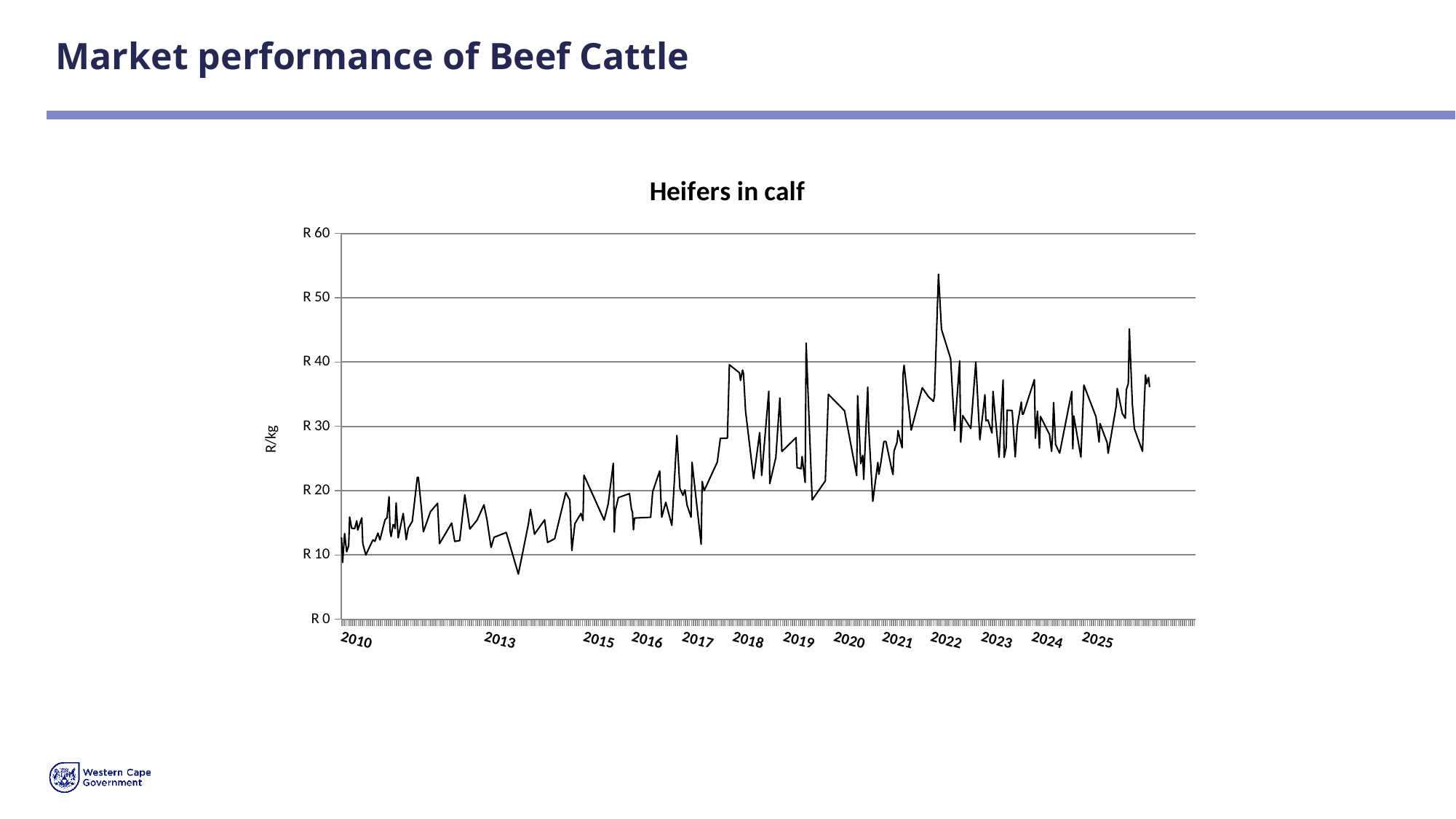
Are the values at the start of the series in 2010 greater or less than R 20? less Overall, do the values rise or fall from 2010 to 2025? Rise Is the spike in the line during 2025 greater or less than R 40? greater Is the lowest point of the line, near 2013, greater or less than R 10? less Around which year does the line reach its lowest value? 2013 What is the highest value shown on the vertical axis? R 60 Around which year does the line reach its highest value? 2022 What is the label on the vertical axis of the chart? R/kg Are the values in 2024 generally higher or lower than the values in 2010? Higher What is the title of the chart? Heifers in calf What kind of chart is shown on the slide? Line chart